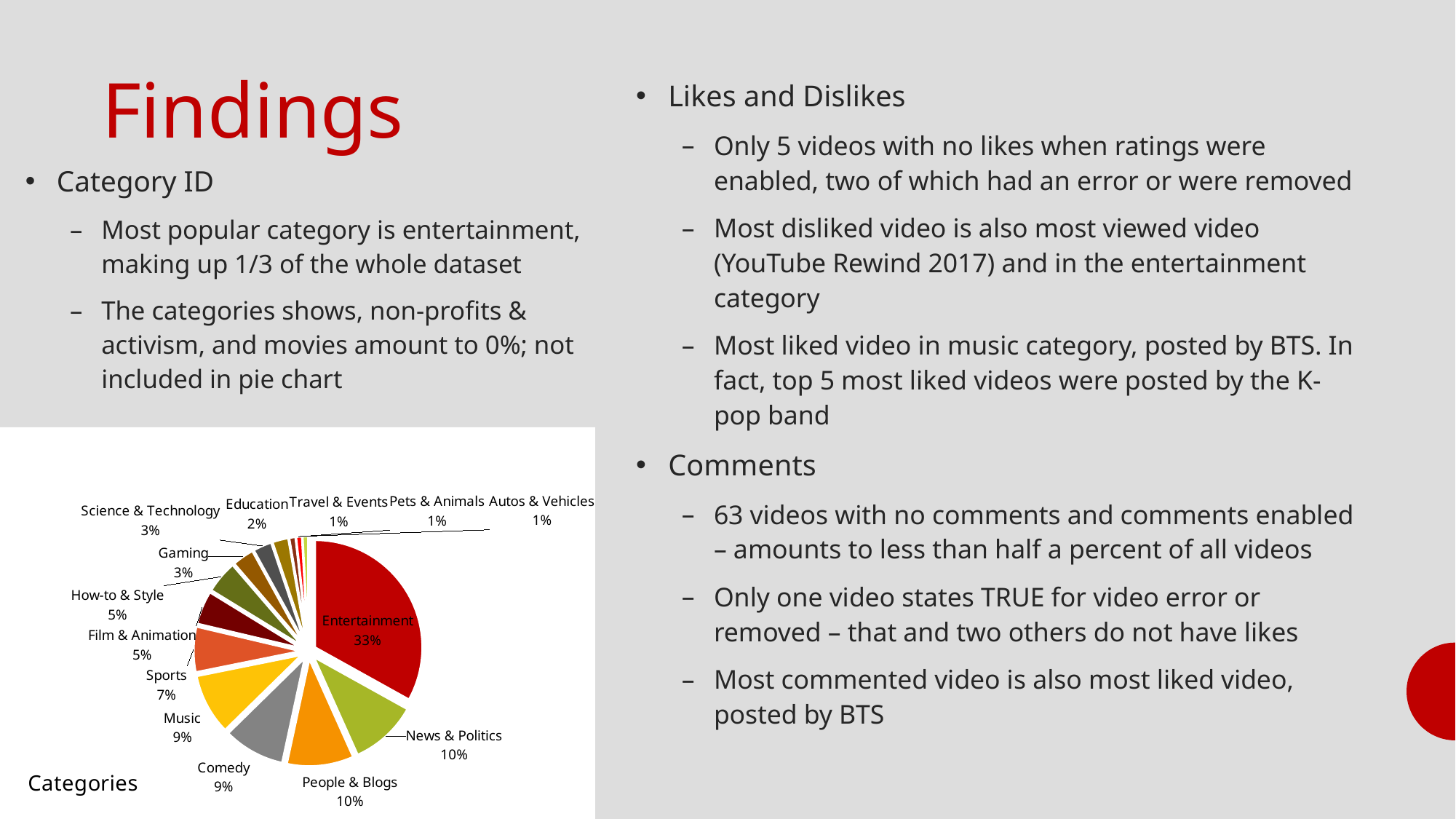
How many categories are shown in the pie chart? 14 What percentage is shown for News & Politics? 10% What is the combined percentage of People & Blogs and Comedy? 19% What percentage is shown for Sports? 7% What type of chart is shown on the slide? pie chart Which category has the largest slice of the pie? Entertainment What is the title of the pie chart? Categories Which is larger, the share for Comedy or the share for Gaming? Comedy What share of the pie does Entertainment account for? 33% What percentage is shown for Education? 2% What is the difference in percentage points between Entertainment and Music? 24 What percentage is shown for Film & Animation? 5%